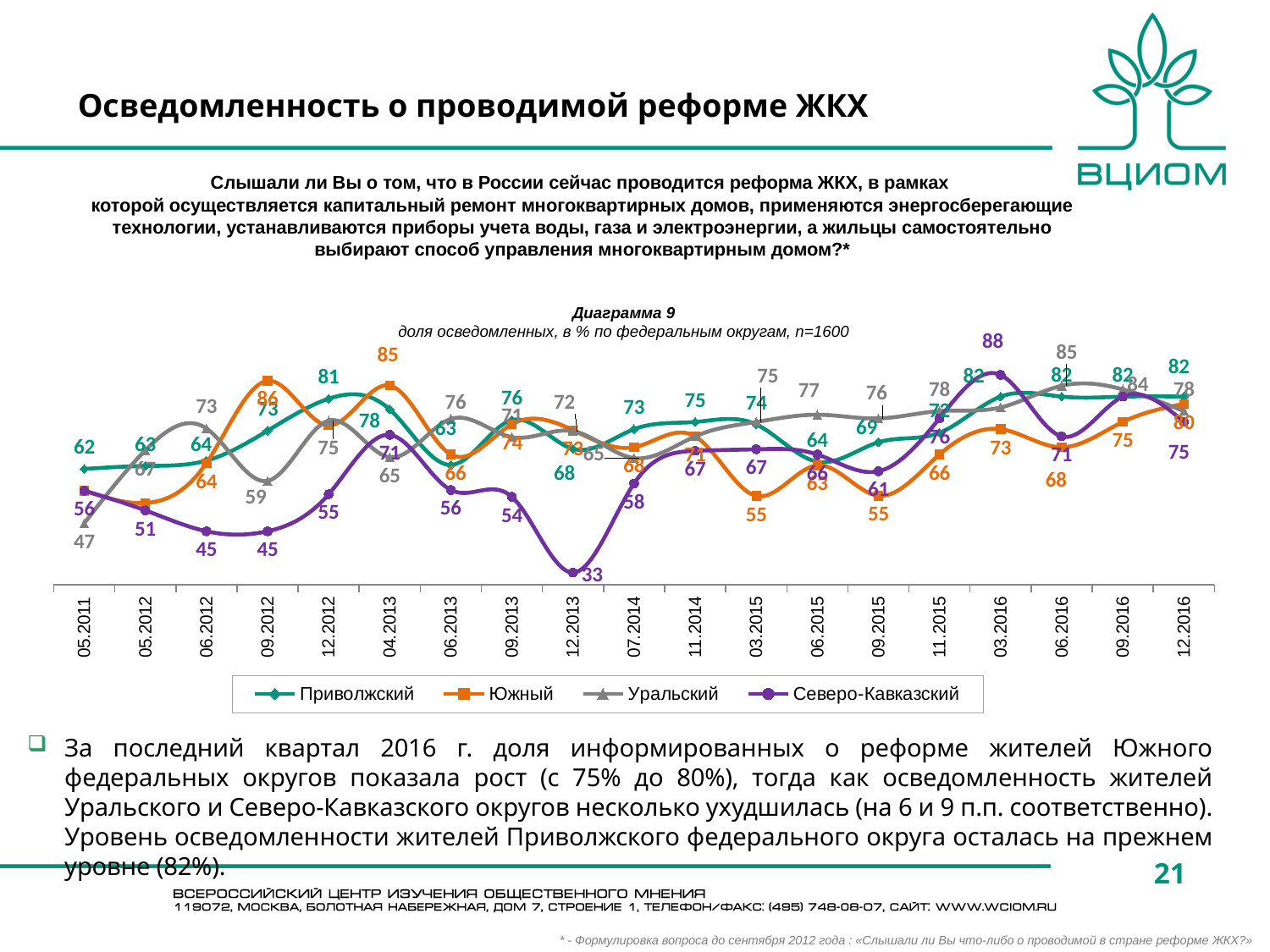
How many series does the legend of the chart list? 4 What is the value for Южный at 12.2016? 80 At 12.2013, which series has the larger value: Приволжский or Северо-Кавказский? Приволжский What is the value for Северо-Кавказский at 03.2016? 88 What is the value for Уральский at 05.2011? 47 At which time point does the Северо-Кавказский series reach its lowest value? 12.2013 How many time points are shown along the x axis of the chart? 19 At which time point does the Северо-Кавказский series reach its highest value? 03.2016 What type of chart is shown on the slide? line chart By how much did the value for Южный change from 09.2016 (75) to 12.2016 (80)? 5 What is the title of the chart? Диаграмма 9 What is the value for Северо-Кавказский at 12.2013? 33